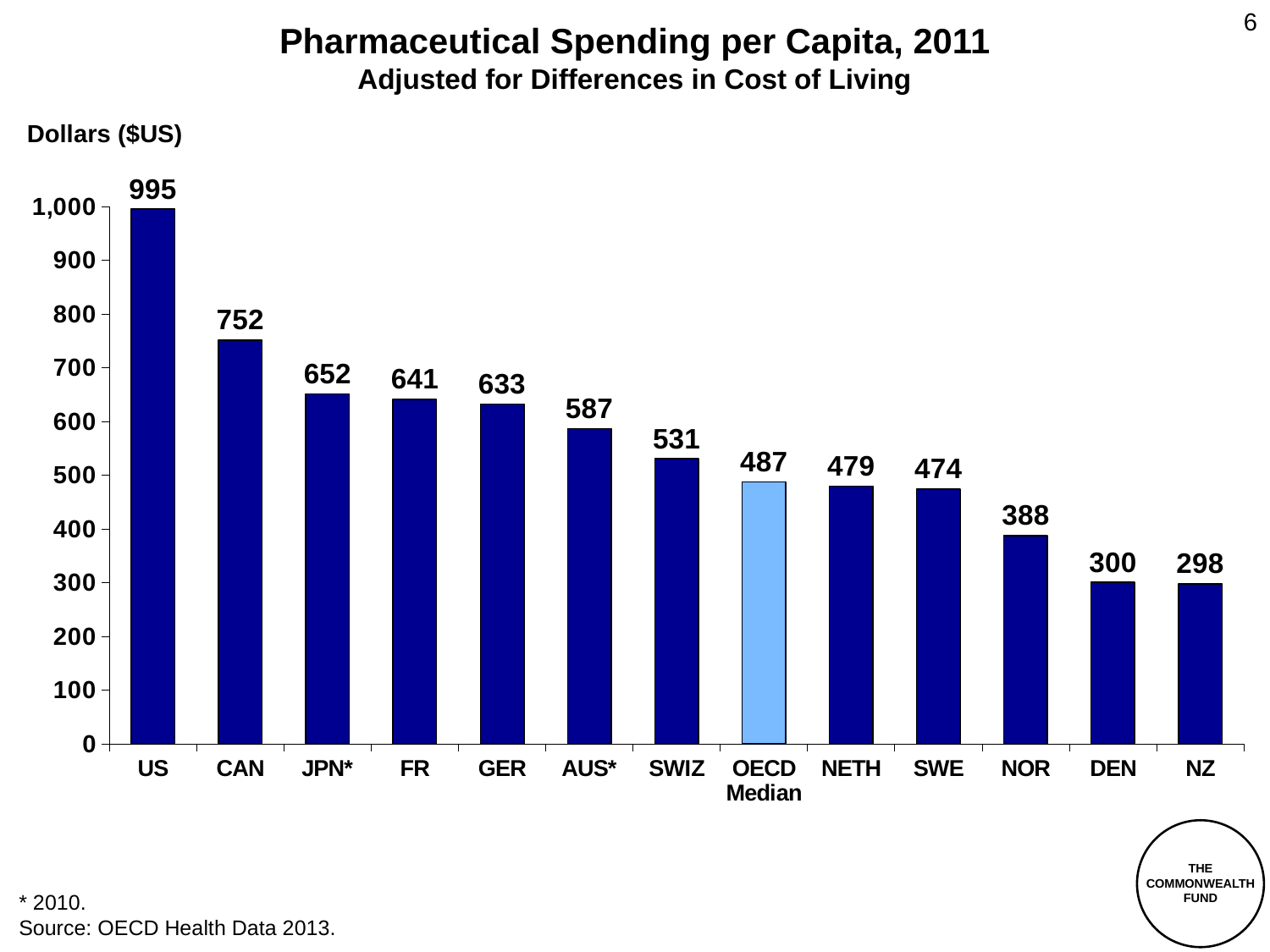
Do the values rise or fall moving from left to right along the x axis? Fall What is the value shown for the OECD Median? 487 What is the pharmaceutical spending per capita for the US? 995 Is the value for AUS* greater or less than 500? greater What kind of chart is shown on the slide? Bar chart Which has a higher value, SWIZ or NETH? SWIZ What is the difference between the GER value and the OECD Median? 146 How many bars are shown in the chart? 13 Which country has the highest pharmaceutical spending per capita? US What is the difference between the US value and the CAN value? 243 What is the pharmaceutical spending per capita for NOR? 388 Which country has the lowest pharmaceutical spending per capita? NZ